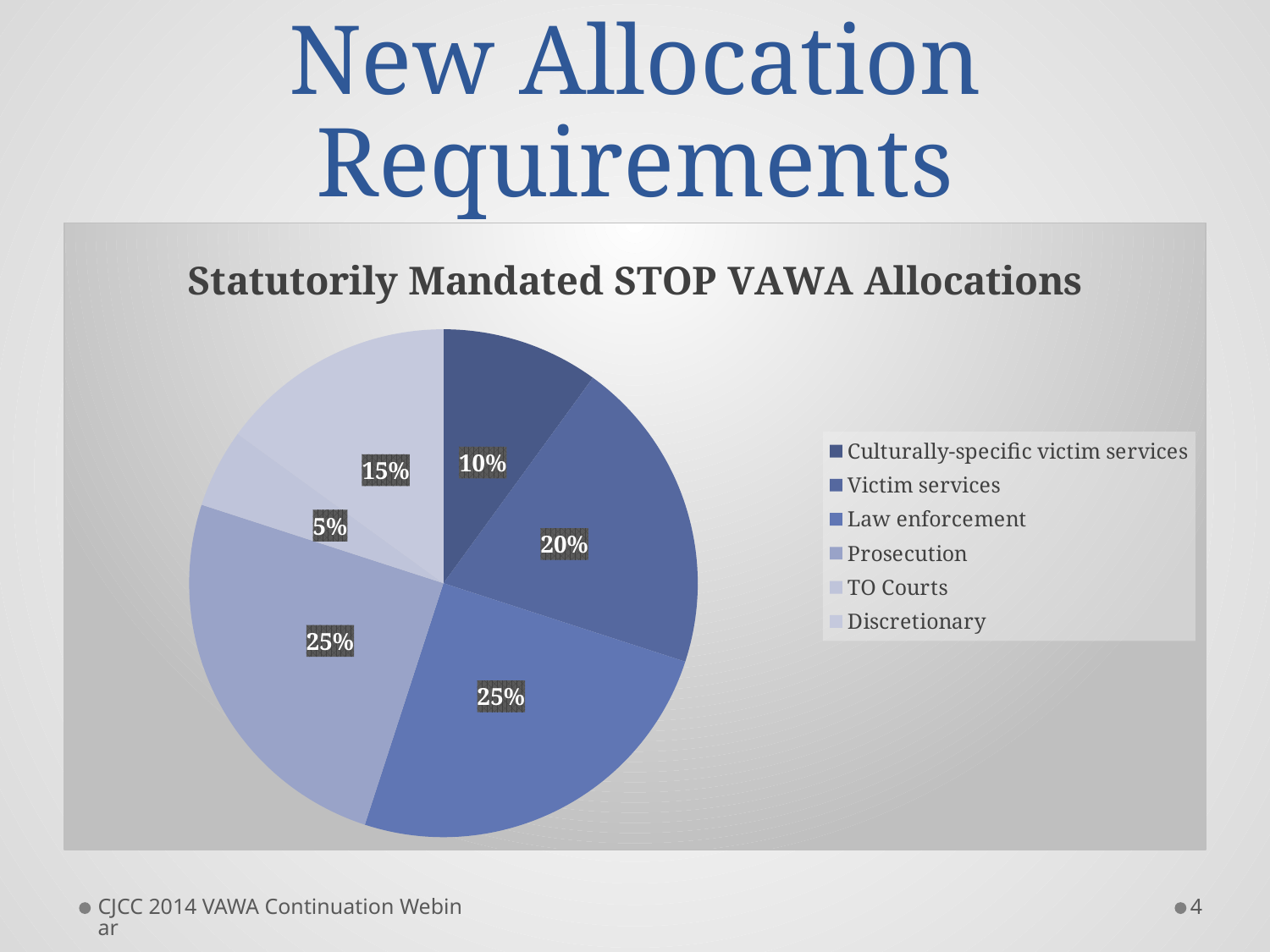
What is the combined share of Law enforcement and Prosecution? 50% What share of the pie is allocated to Culturally-specific victim services? 10% What kind of chart is shown on the slide? pie chart What share of the pie is allocated to Victim services? 20% How many categories does the pie chart show? 6 What share of the pie is allocated to Law enforcement? 25% Which is larger, the Discretionary share or the TO Courts share? Discretionary Which category has the smallest slice of the pie? TO Courts What is the title of the chart? Statutorily Mandated STOP VAWA Allocations What is the difference between the Victim services share and the Culturally-specific victim services share? 10%